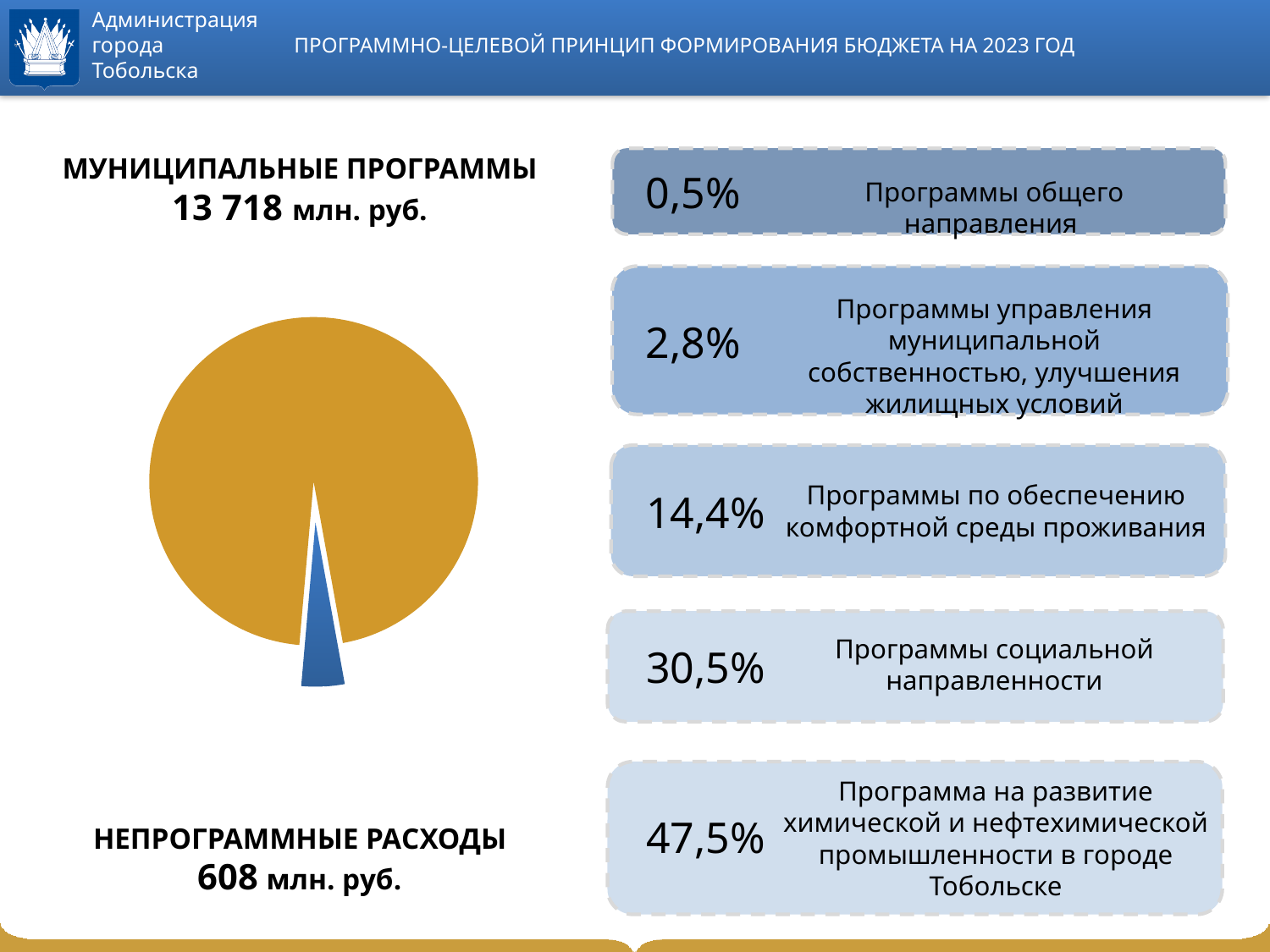
What is the value shown for НЕПРОГРАММНЫЕ РАСХОДЫ? 608 млн. руб. Which category in the pie chart has the largest value? МУНИЦИПАЛЬНЫЕ ПРОГРАММЫ What kind of chart is shown on the left of the slide? pie chart How many slices does the pie chart have? 2 What is the difference between the value for МУНИЦИПАЛЬНЫЕ ПРОГРАММЫ and the value for НЕПРОГРАММНЫЕ РАСХОДЫ? 13 110 млн. руб. Which is larger in the pie chart: municipal programs (МУНИЦИПАЛЬНЫЕ ПРОГРАММЫ) or non-program expenses (НЕПРОГРАММНЫЕ РАСХОДЫ)? МУНИЦИПАЛЬНЫЕ ПРОГРАММЫ What colour is the slice representing МУНИЦИПАЛЬНЫЕ ПРОГРАММЫ in the pie chart? gold What colour is the slice representing НЕПРОГРАММНЫЕ РАСХОДЫ in the pie chart? blue What is the value shown for МУНИЦИПАЛЬНЫЕ ПРОГРАММЫ? 13 718 млн. руб. Which category in the pie chart has the smallest value? НЕПРОГРАММНЫЕ РАСХОДЫ